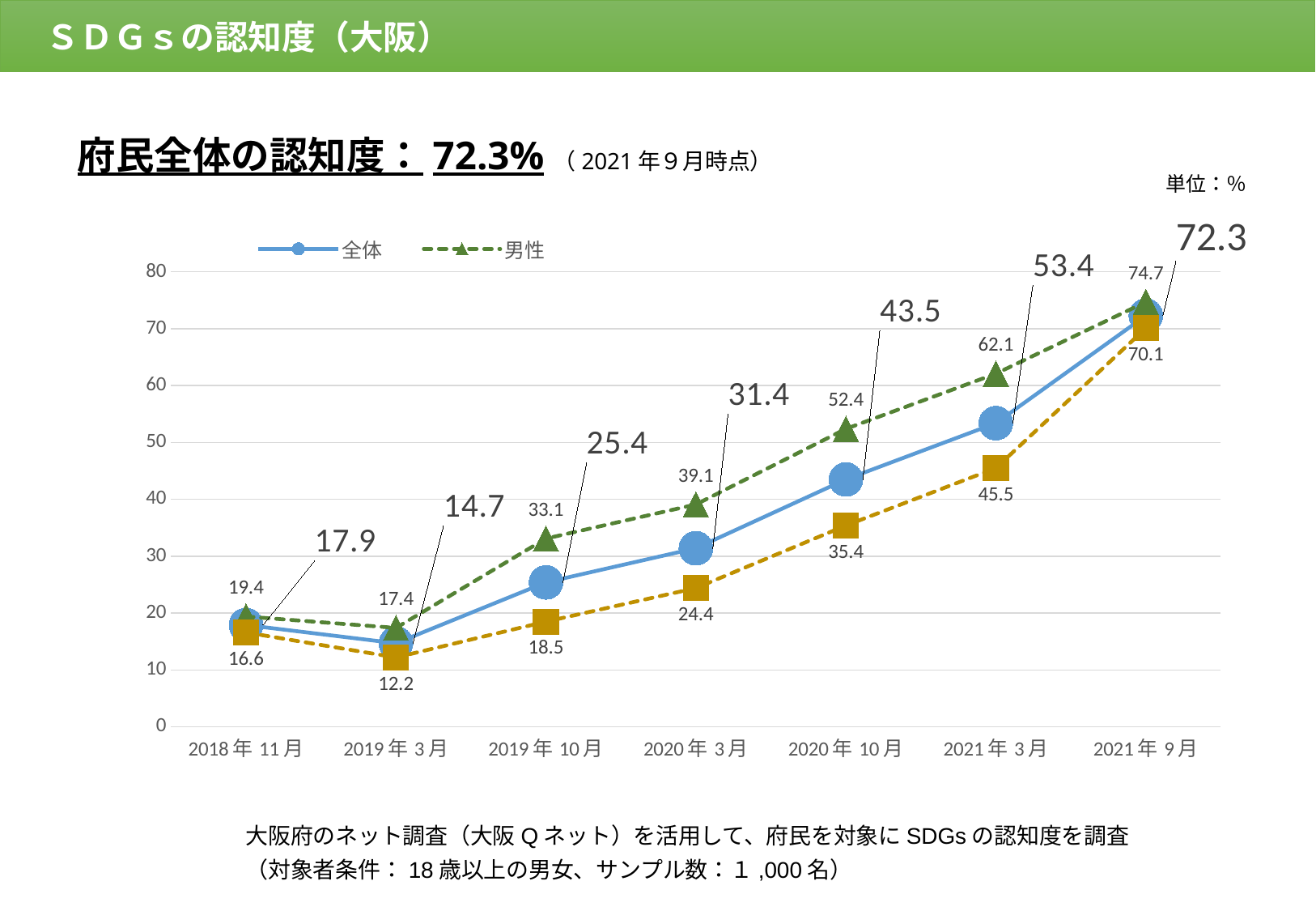
What unit is indicated for the chart values? % What is the value for 全体 at 2019年3月? 14.7 What is the difference between the 男性 and 全体 values at 2021年3月? 8.7 How many series does the legend list? 2 Which is larger at 2020年3月, the 全体 value or the 男性 value? 男性 What kind of chart is shown on the slide? line chart From 2019年3月 to 2021年9月, does the 全体 value rise or fall? rise At which time point is the 全体 value lowest? 2019年3月 How many time points are shown on the x axis? 7 At which time point is the 男性 value highest? 2021年9月 What is the value for 全体 at 2021年9月? 72.3 What is the value for 男性 at 2020年10月? 52.4